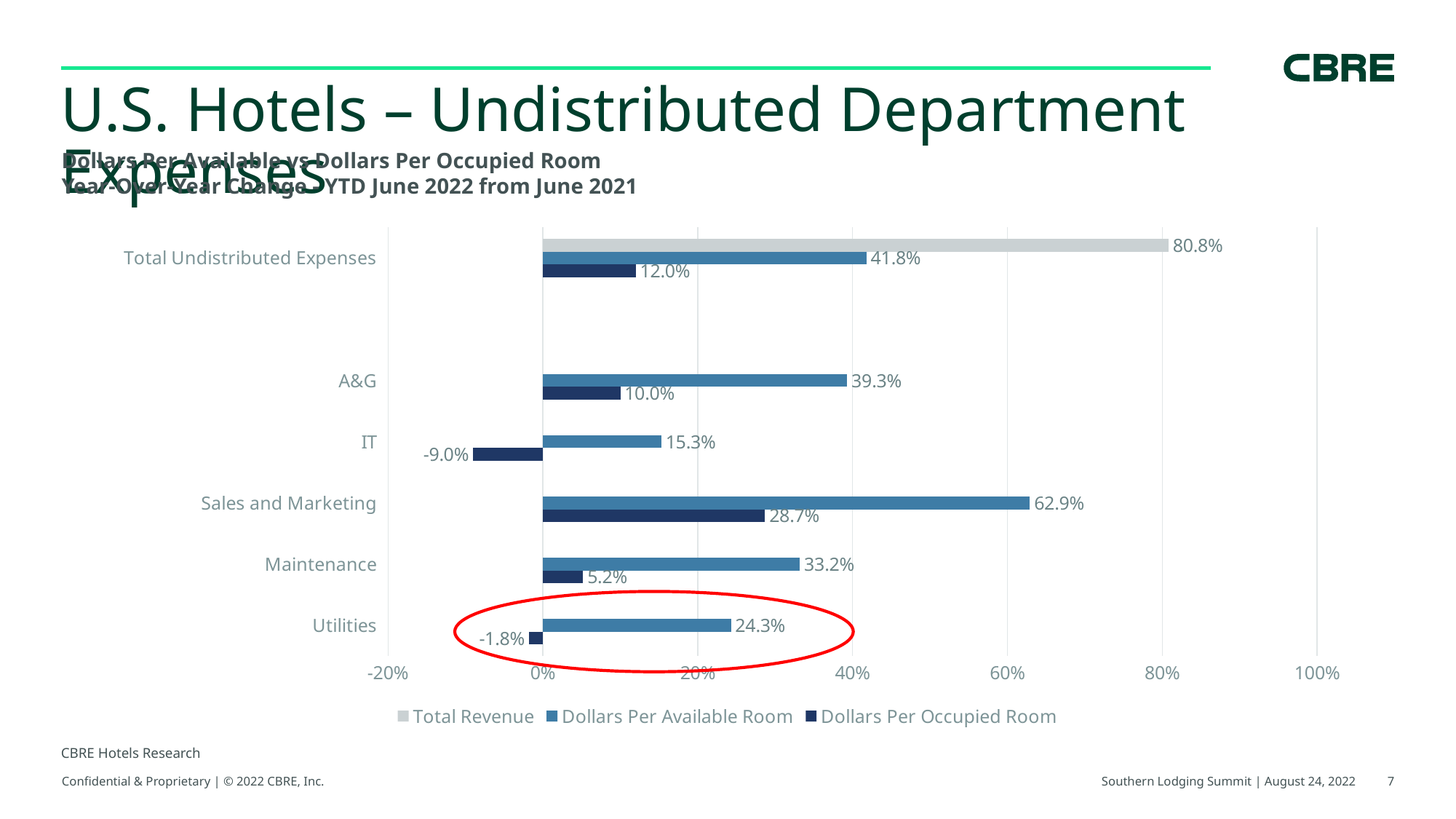
Which category has the highest Dollars Per Available Room value? Sales and Marketing How many categories are shown on the y axis of the chart? 6 What is the Total Revenue value shown for Total Undistributed Expenses? 80.8% What is the Dollars Per Occupied Room value for IT? -9.0% What is the difference between the Dollars Per Available Room and Dollars Per Occupied Room values for Maintenance? 28.0% What is the Dollars Per Occupied Room value for Utilities? -1.8% Which category has the lowest Dollars Per Occupied Room value? IT What kind of chart is shown on the slide? Bar chart What is the Dollars Per Available Room value for Sales and Marketing? 62.9% How many series does the legend list? 3 Which is larger: the Dollars Per Available Room value for A&G or for Maintenance? A&G Is the Dollars Per Available Room value for Total Undistributed Expenses greater or less than 40%? greater